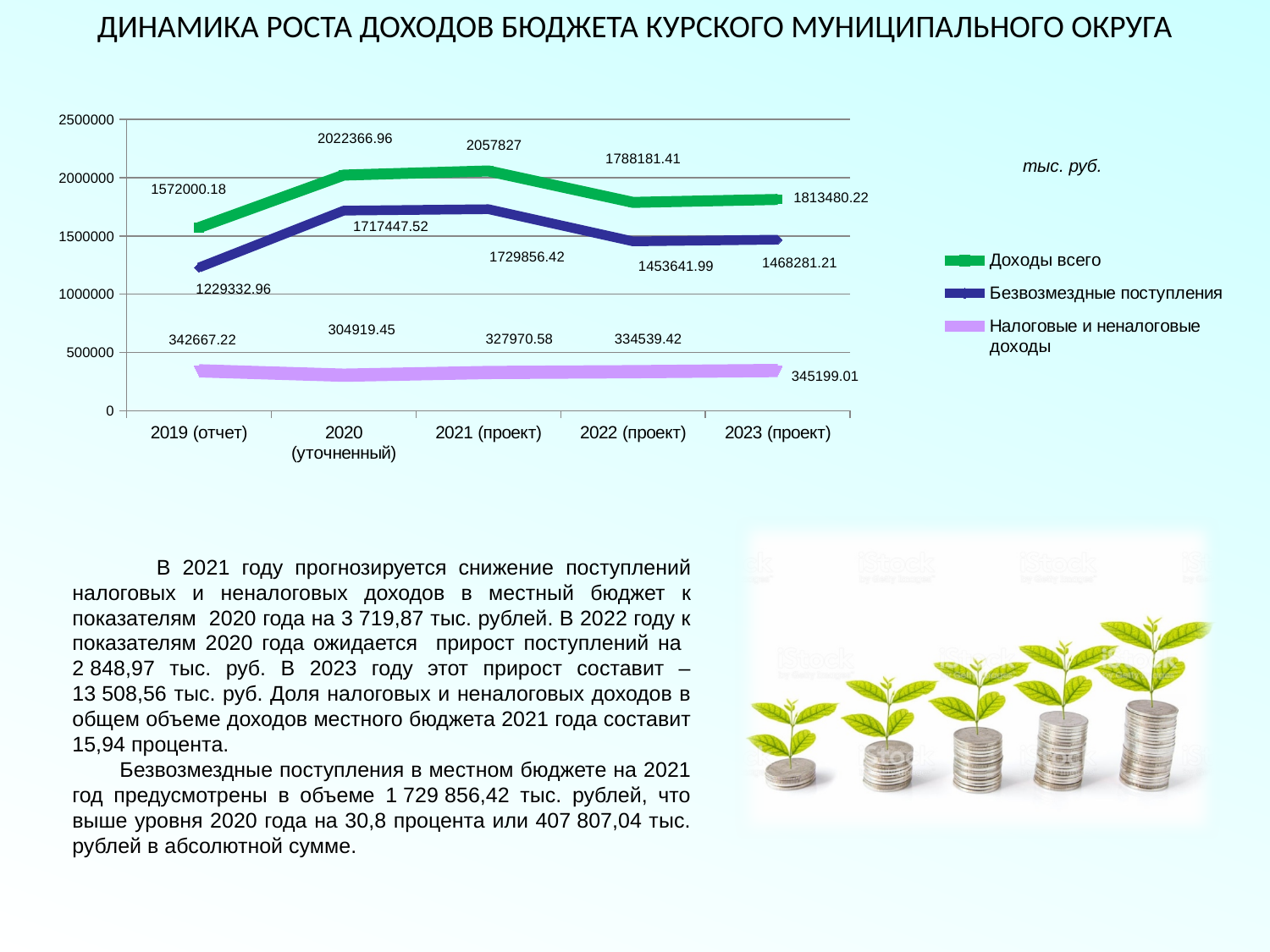
What type of chart is shown on the slide? Line chart What unit is indicated next to the chart? тыс. руб. What is the difference between Доходы всего in 2021 (проект) and 2020 (уточненный)? 35460.04 How many series does the legend list? 3 What is the value of Доходы всего for 2021 (проект)? 2057827 What is the value of Налоговые и неналоговые доходы for 2023 (проект)? 345199.01 Does Доходы всего rise or fall from 2019 (отчет) to 2020 (уточненный)? Rise In which year is Доходы всего the highest? 2021 (проект) Which is larger: Безвозмездные поступления in 2022 (проект) or in 2023 (проект)? 2023 (проект) How many years (categories) are plotted on the x axis? 5 In which year is Налоговые и неналоговые доходы the lowest? 2020 (уточненный) What is the value of Безвозмездные поступления for 2019 (отчет)? 1229332.96